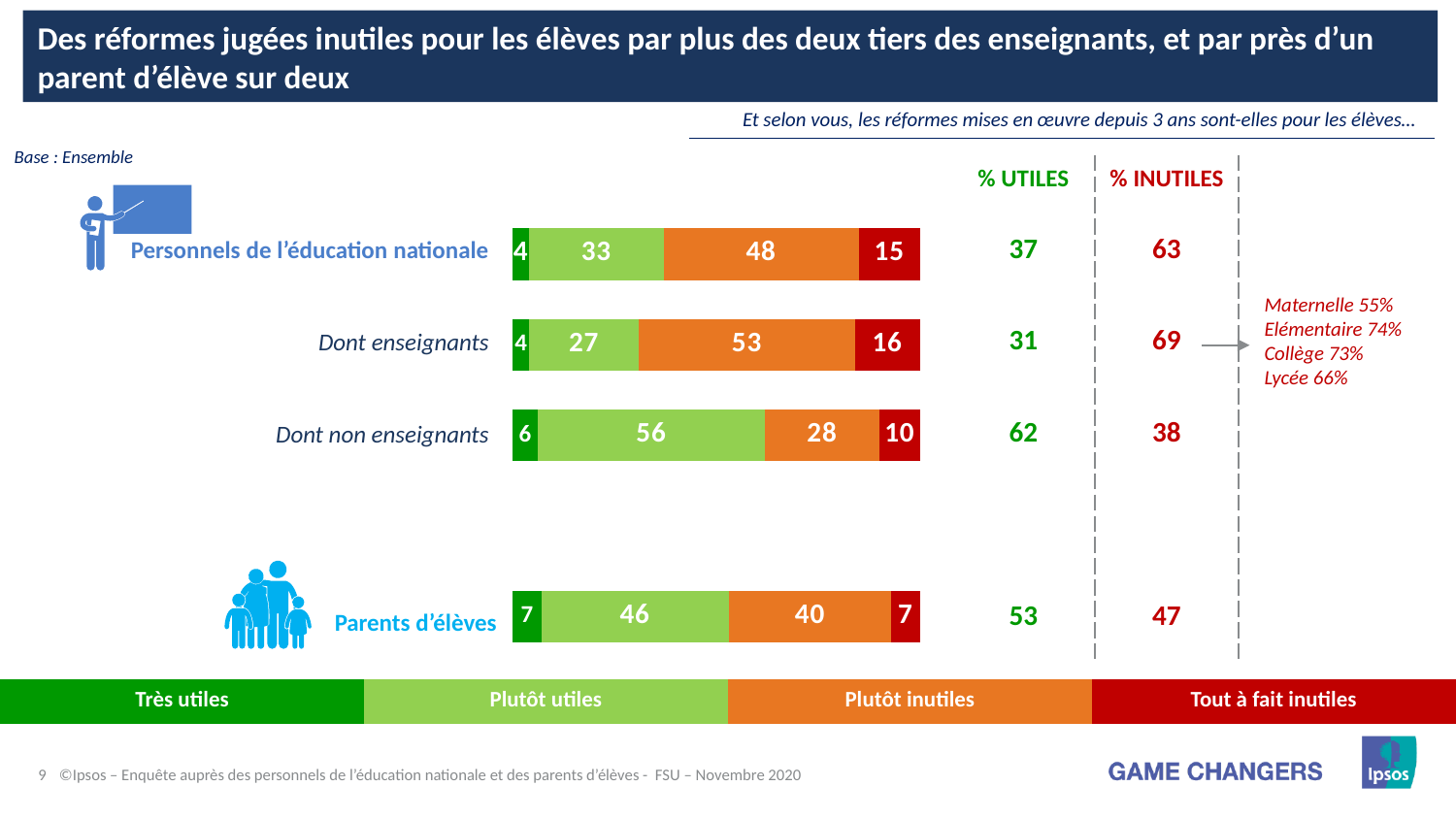
Which category has the lowest value for "Tout à fait inutiles"? Parents d'élèves How many series does the legend list? 4 Which is larger: the "Plutôt utiles" value for "Parents d'élèves" or for "Personnels de l'éducation nationale"? Parents d'élèves What is the "% UTILES" figure shown for "Dont non enseignants"? 62 What is the total of the "Plutôt inutiles" and "Tout à fait inutiles" segments for "Dont enseignants"? 69 What is the value for "Plutôt inutiles" for "Dont enseignants"? 53 What kind of chart is shown on the slide? Stacked bar chart What is the value for "Très utiles" for "Parents d'élèves"? 7 How many categories (bars) are shown in the chart? 4 Which category has the highest value for "Plutôt utiles"? Dont non enseignants What is the "% INUTILES" figure shown for "Personnels de l'éducation nationale"? 63 What is the difference between the "Plutôt inutiles" values for "Dont enseignants" and "Dont non enseignants"? 25